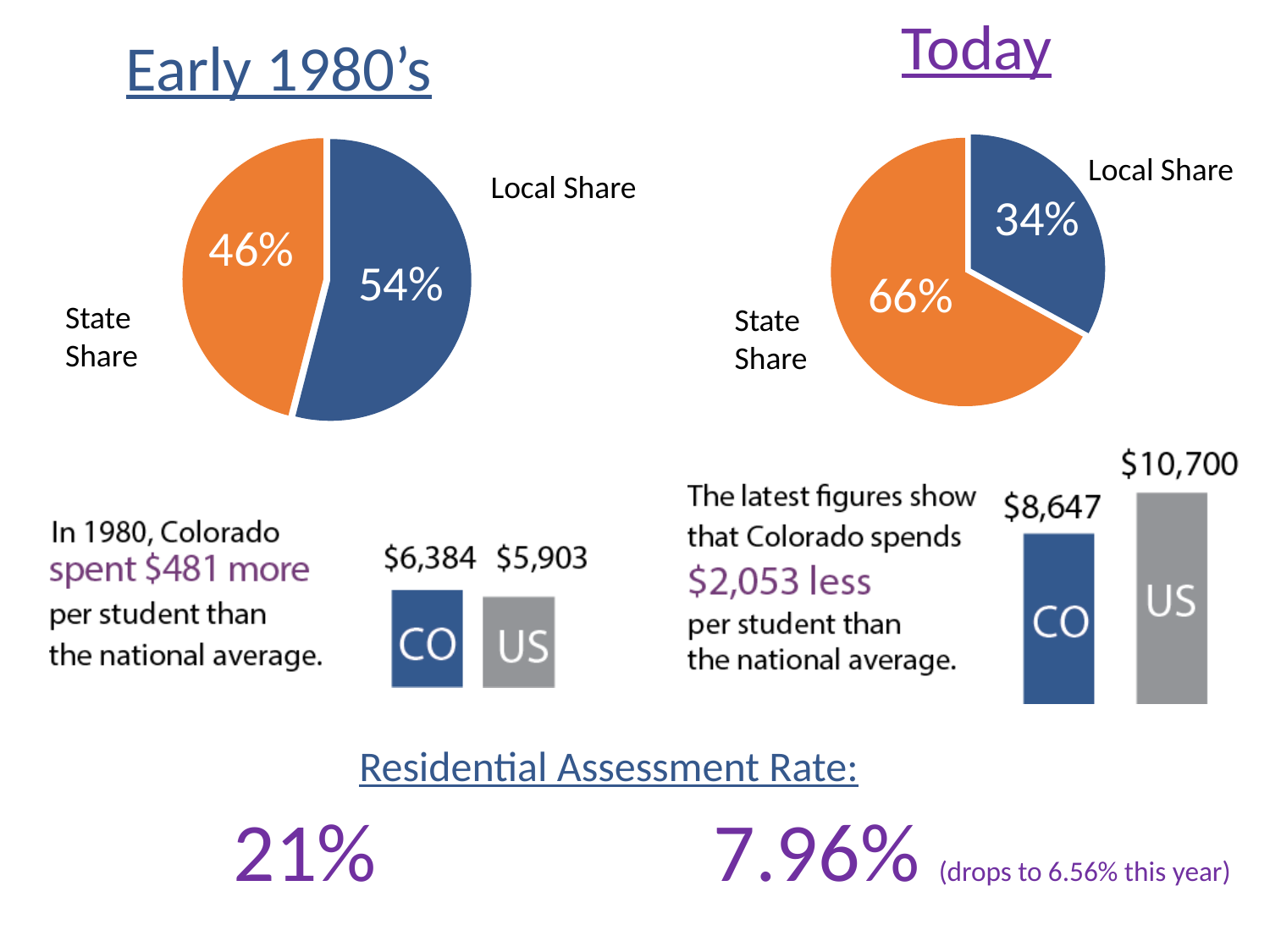
In the 1980 per-student spending bar chart, what is the value for US? $5,903 In the Today pie chart, what is the State Share? 66% In the latest-figures per-student spending bar chart, what is the difference between US and CO? $2,053 In the 1980 per-student spending bar chart, what is the value for CO? $6,384 In the Today pie chart, what is the Local Share? 34% How many slices does the Early 1980's pie chart have? 2 In the Early 1980's pie chart, what is the Local Share? 54% In the Early 1980's pie chart, what is the State Share? 46% In the Today pie chart, which slice is larger, State Share or Local Share? State Share In the Early 1980's pie chart, which slice is the largest? Local Share What kind of chart is used to show the State Share and Local Share for Today? Pie chart In the latest-figures per-student spending bar chart, what is the value for US? $10,700